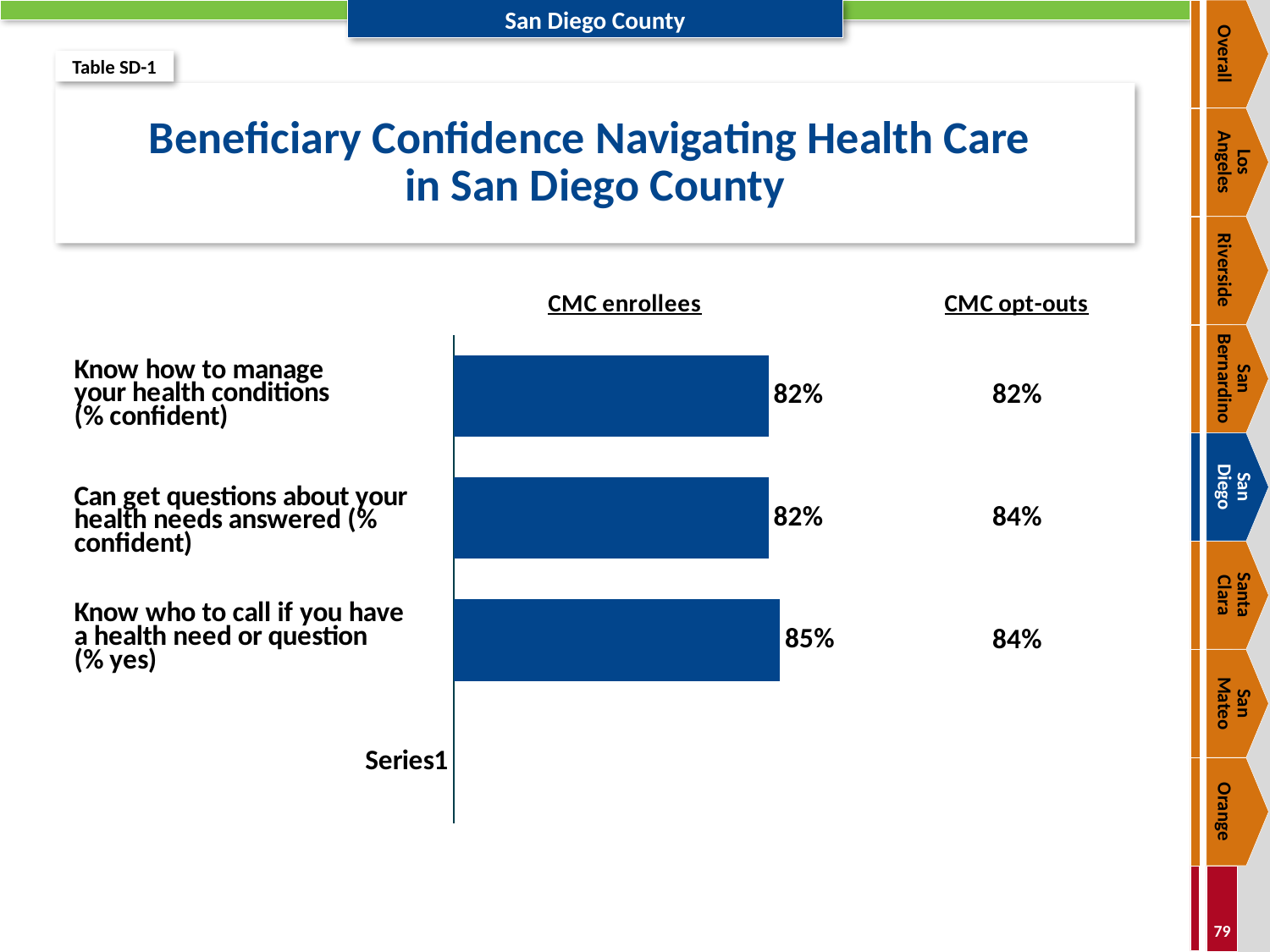
How many bars are plotted in the chart? 3 What is the difference between the CMC enrollees values for "Know who to call if you have a health need or question" and "Know how to manage your health conditions"? 3 percentage points What is the difference between the CMC opt-outs and CMC enrollees values for "Can get questions about your health needs answered"? 2 percentage points What is the CMC enrollees value for "Know who to call if you have a health need or question (% yes)"? 85% What is the title of the chart on the slide? Beneficiary Confidence Navigating Health Care in San Diego County What is the CMC enrollees value for "Know how to manage your health conditions (% confident)"? 82% What type of chart is shown on the slide? Bar chart For "Know who to call if you have a health need or question", which group has the larger value, CMC enrollees or CMC opt-outs? CMC enrollees What is the CMC opt-outs value for "Can get questions about your health needs answered (% confident)"? 84% Which item has the highest CMC enrollees value? Know who to call if you have a health need or question (% yes) What is the CMC opt-outs value for "Know how to manage your health conditions (% confident)"? 82% For "Can get questions about your health needs answered", which group has the larger value, CMC enrollees or CMC opt-outs? CMC opt-outs